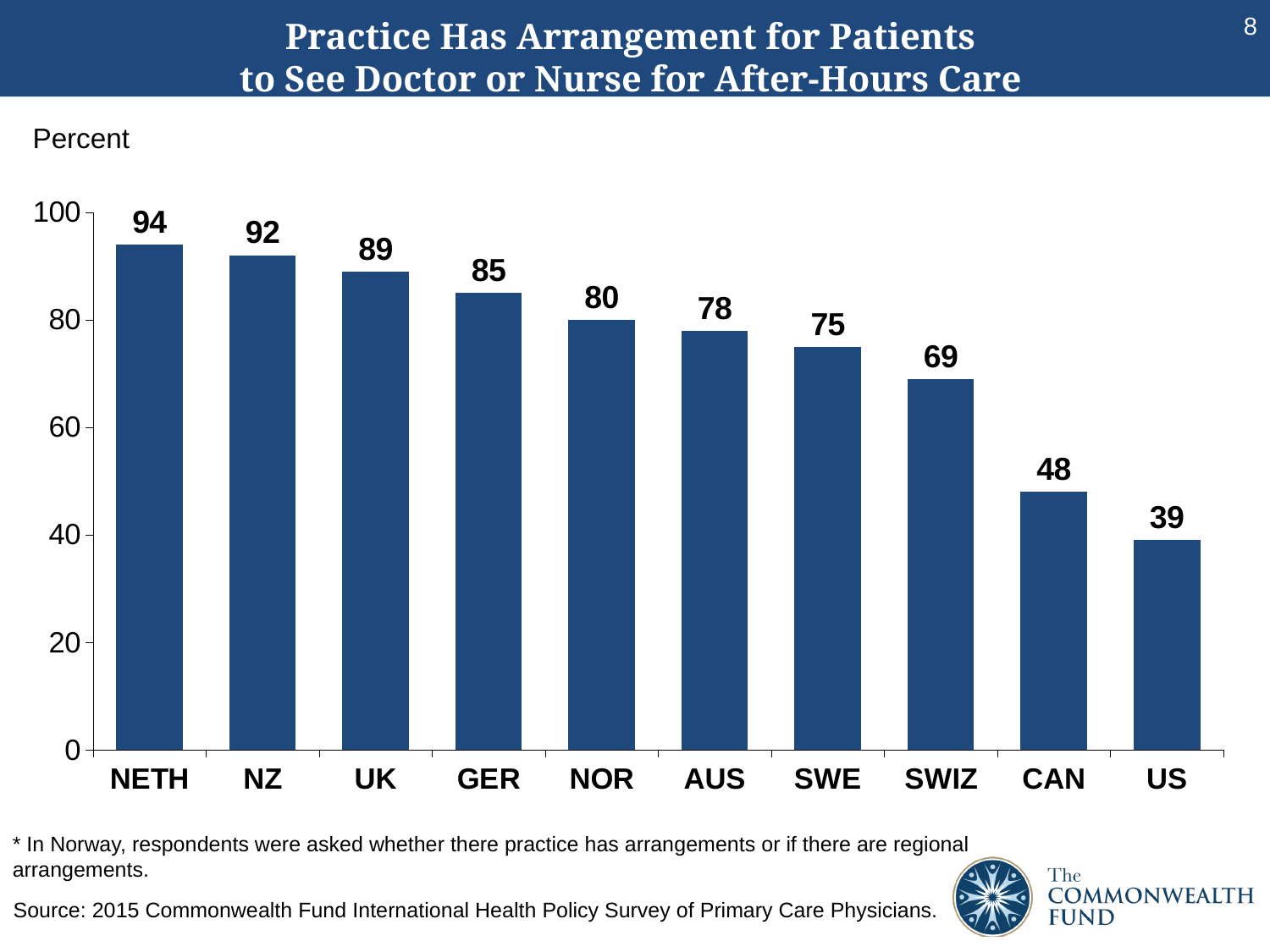
What kind of chart is shown on the slide? bar chart Which country has the lowest value? US Which country has the highest value? NETH What is the difference between the values for NETH and US? 55 Is the value for CAN greater or less than 60? less How many countries are shown on the chart? 10 Do the values rise or fall from left to right along the x axis? fall What is the value for US? 39 What is the value for SWIZ? 69 What is the difference between the values for SWIZ and CAN? 21 Which is larger, the value for GER or the value for NOR? GER What is the value for NETH? 94